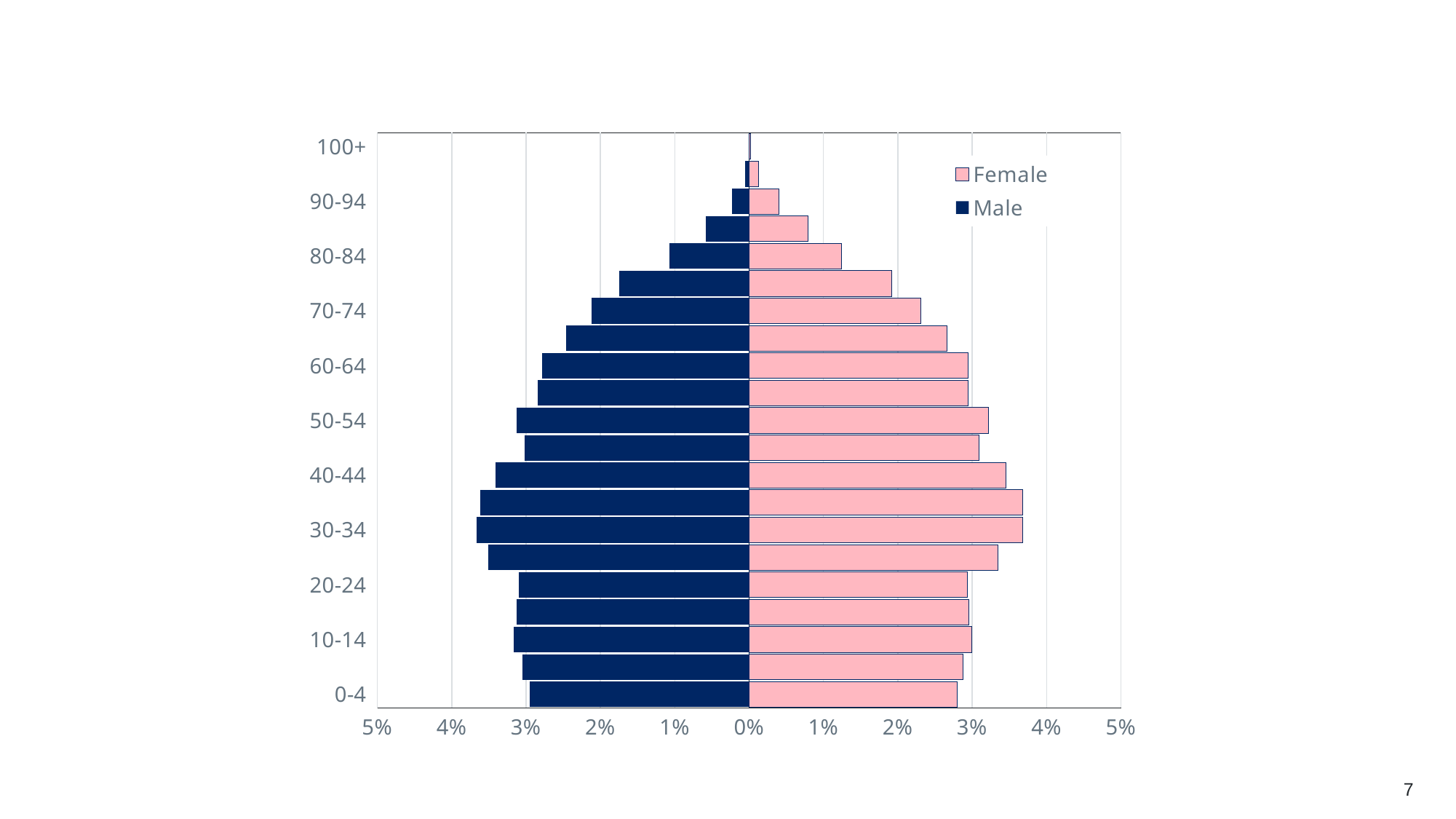
Which series is shown in dark blue? Male For the 80-84 age group, which is larger, the Male value or the Female value? Female How many series does the legend list? 2 Which series is shown in pink? Female Is the Male value for the 30-34 age group greater or less than 3%? greater Is the Female value for the 0-4 age group greater or less than 3%? less What kind of chart is shown on the slide? bar chart Is the Female value for the 80-84 age group greater or less than 1%? greater How many age groups are plotted on the vertical axis? 21 Which age group has the smallest Male value? 100+